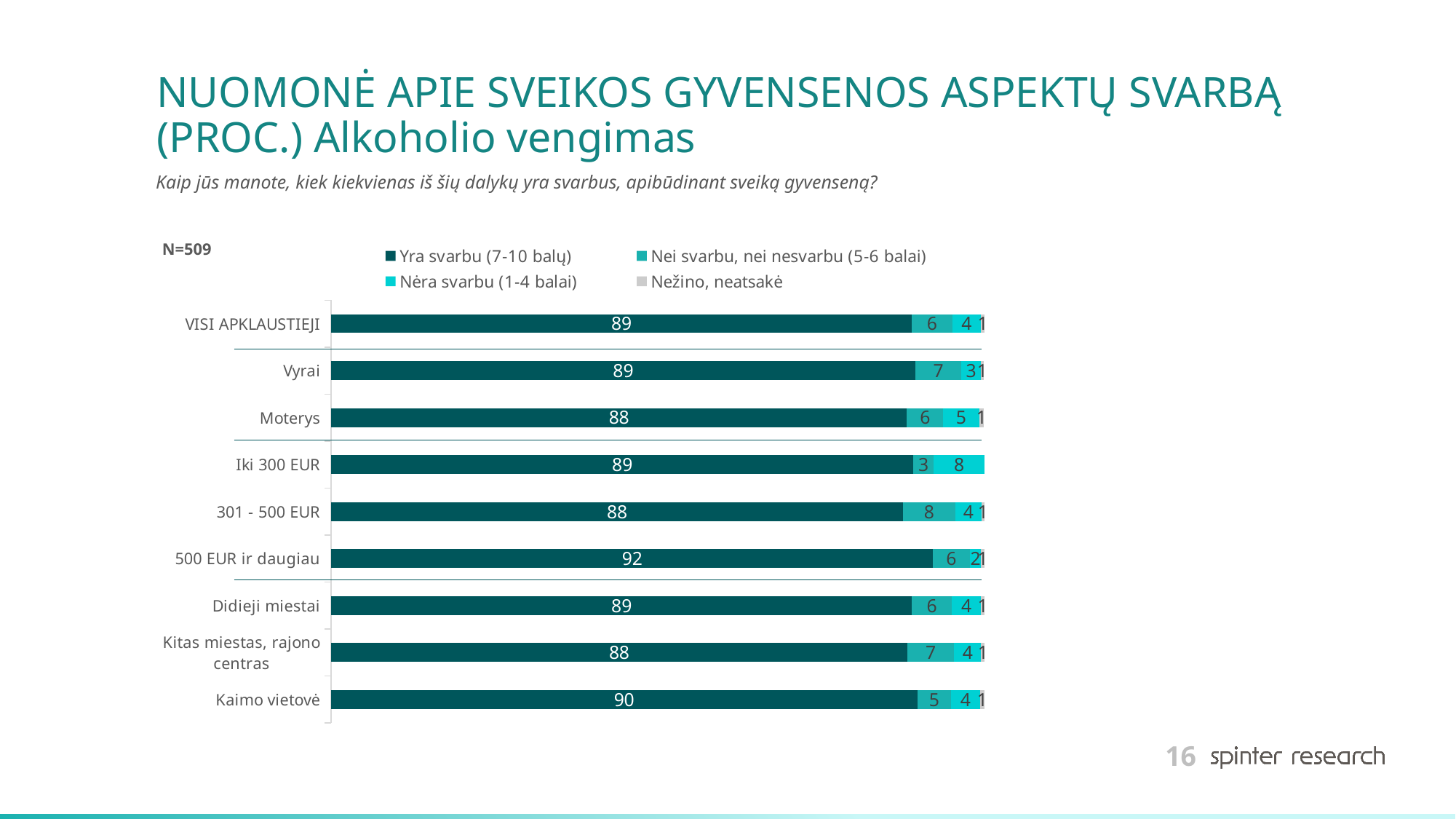
What is the value of "Nėra svarbu (1-4 balai)" for Iki 300 EUR? 8 Which has a larger "Yra svarbu (7-10 balų)" value, Kaimo vietovė or Moterys? Kaimo vietovė What kind of chart is shown on the slide? Stacked bar chart What is the value of "Nei svarbu, nei nesvarbu (5-6 balai)" for 301 - 500 EUR? 8 Which category has the highest value for "Yra svarbu (7-10 balų)"? 500 EUR ir daugiau What is the value of "Yra svarbu (7-10 balų)" for Kaimo vietovė? 90 What is the difference between the "Yra svarbu (7-10 balų)" values for 500 EUR ir daugiau and 301 - 500 EUR? 4 What sample size (N) is stated on the slide? N=509 What is the value of "Yra svarbu (7-10 balų)" for 500 EUR ir daugiau? 92 Which category has the highest value for "Nėra svarbu (1-4 balai)"? Iki 300 EUR How many categories are shown on the chart? 9 How many series does the legend list? 4